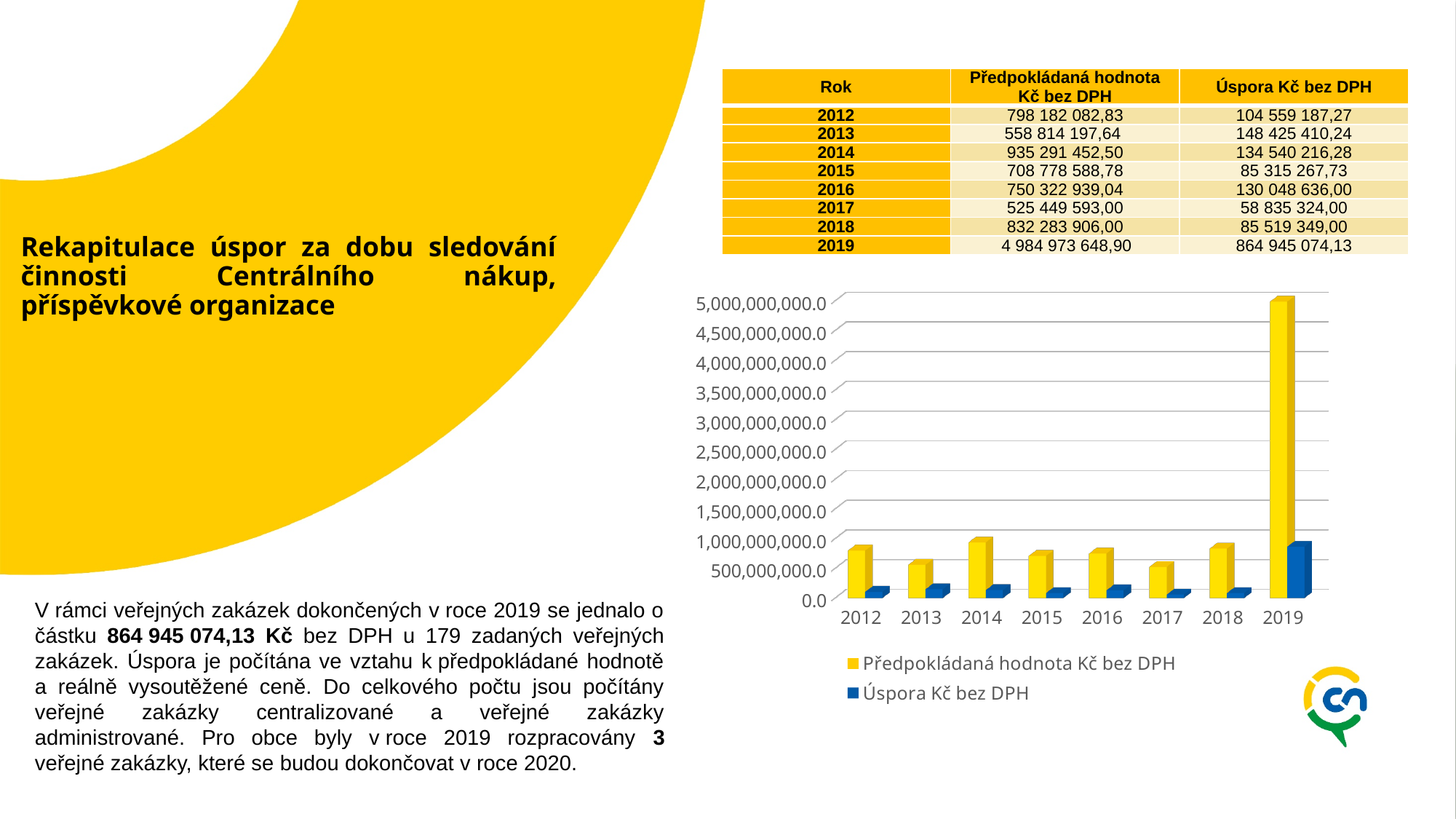
Which year has the lowest value for Předpokládaná hodnota Kč bez DPH? 2017 Is the value for Předpokládaná hodnota Kč bez DPH in 2017 greater or less than 1,000,000,000.0? less Is the value for Předpokládaná hodnota Kč bez DPH in 2019 greater or less than 4,500,000,000.0? greater Which year has the larger Předpokládaná hodnota Kč bez DPH, 2013 or 2014? 2014 Which year has the highest value for Předpokládaná hodnota Kč bez DPH? 2019 Which year has the highest value for Úspora Kč bez DPH? 2019 How many years are shown on the x axis of the chart? 8 What is the Předpokládaná hodnota Kč bez DPH value for 2014, as printed in the table on the slide? 935 291 452,50 What kind of chart is shown on the slide? bar chart Which series is shown in blue in the chart legend? Úspora Kč bez DPH What is the Úspora Kč bez DPH value for 2019, as printed in the table on the slide? 864 945 074,13 How many series does the chart legend list? 2